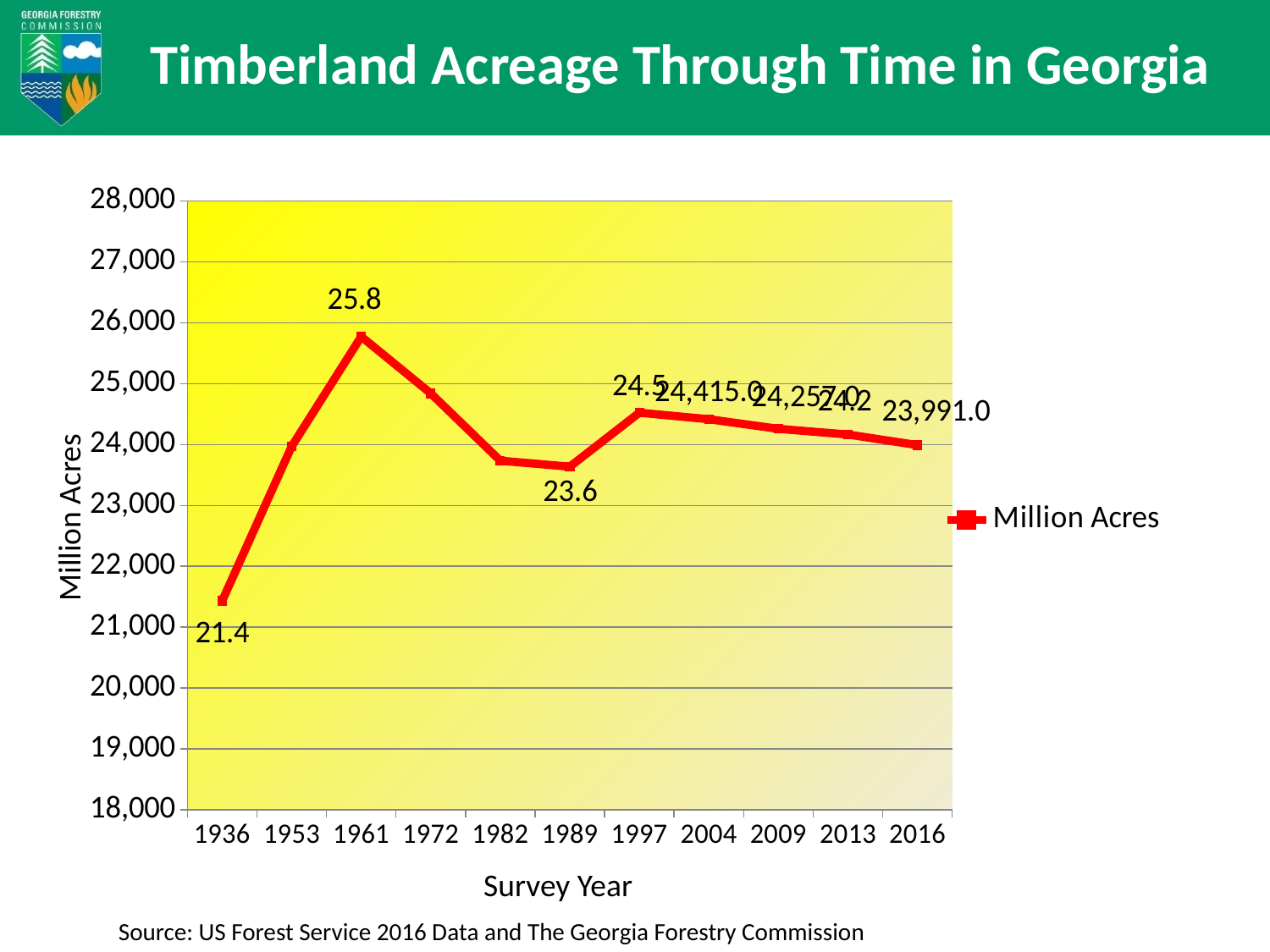
How many series does the legend list? 1 How many survey years are plotted on the x axis? 11 What is the difference between the labelled values for 1961 and 1936? 4.4 What is the data label shown for 1936? 21.4 What is the data label shown for 1989? 23.6 Is the value for 1972 greater or less than 24,000? greater What is the title of the x axis? Survey Year What kind of chart is shown on the slide? line chart Which survey year has the highest timberland acreage? 1961 What is the data label shown for 2016? 23,991.0 What is the data label shown for 1961? 25.8 Which survey year has the lowest timberland acreage? 1936